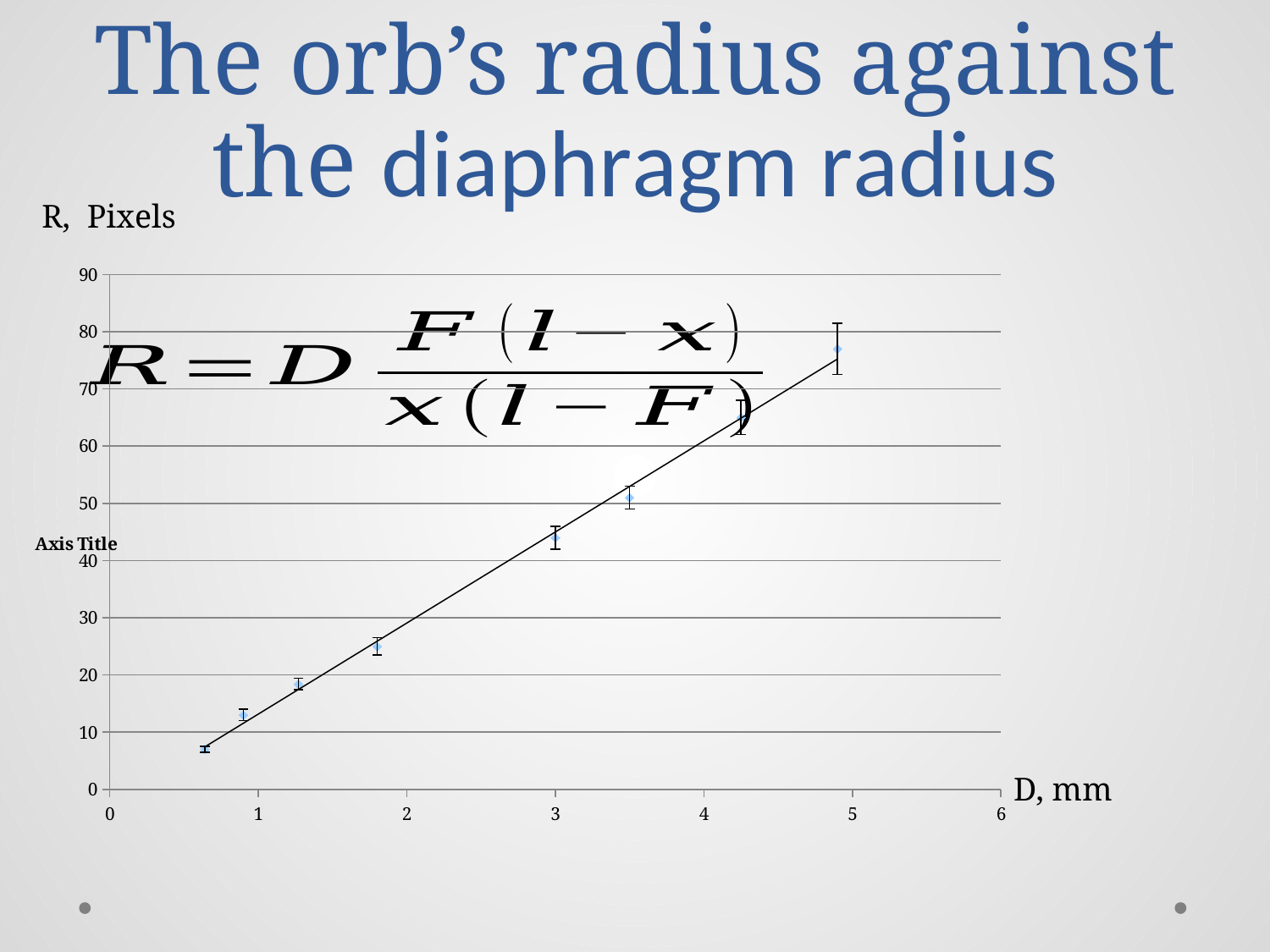
What is the label on the x axis of the chart? D, mm Which data point has the highest R value: the one at D = 3 mm or the one near D = 5 mm? the one near D = 5 mm Is the value of R for the data point at D = 3 mm greater or less than 40? greater How many data points are plotted on the chart? 8 Is the value of R for the leftmost data point greater or less than 10? less Is the value of R for the data point near D = 1.8 mm greater or less than 30? less What kind of chart is shown on the slide? scatter chart What is the title of the chart on the slide? The orb's radius against the diaphragm radius Do the plotted values rise or fall as D increases along the x axis? rise